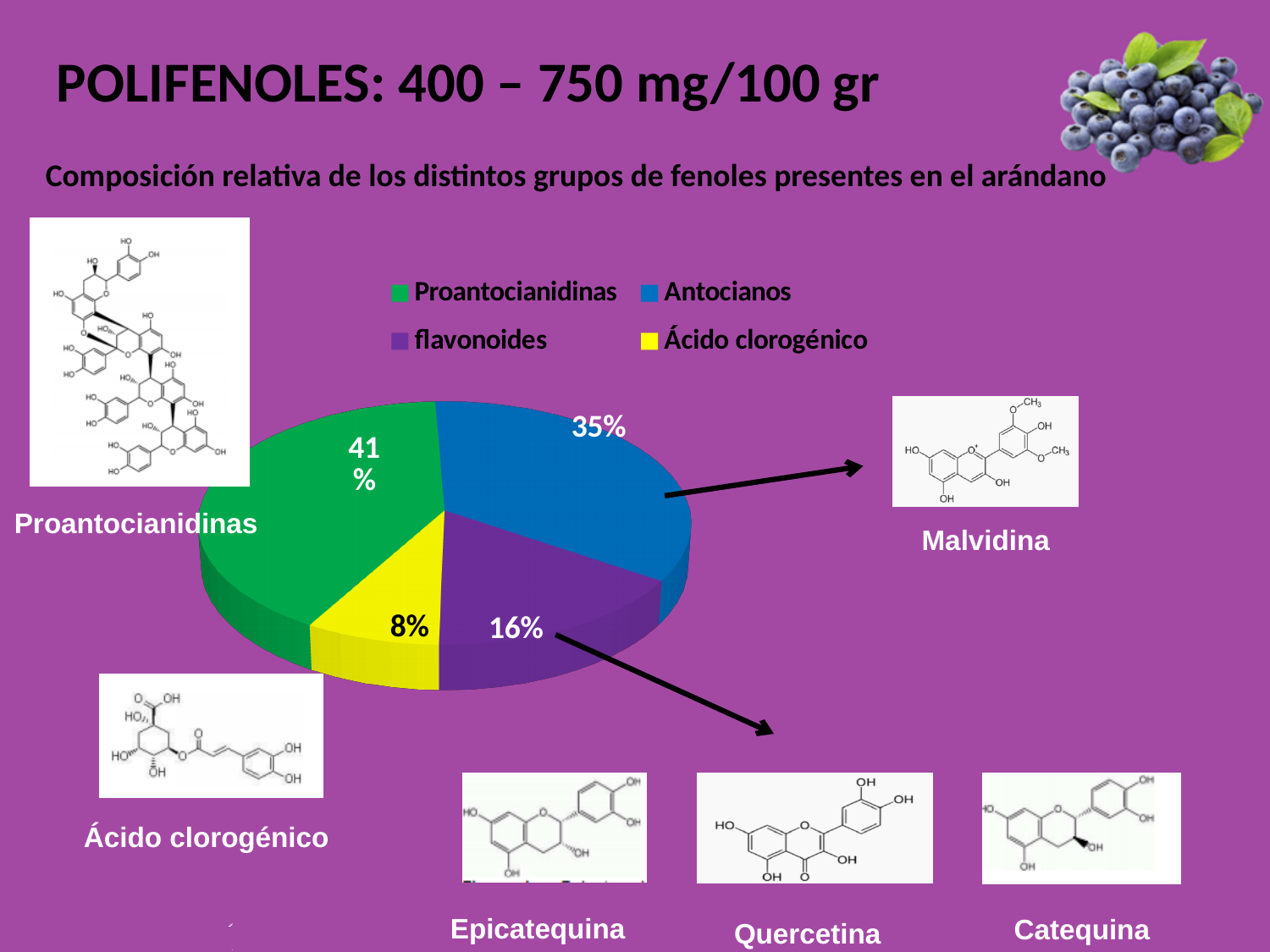
What is the difference in percentage points between flavonoides and Ácido clorogénico? 8 What percentage of the pie chart corresponds to Antocianos? 35% How many slices does the pie chart have? 4 What percentage of the pie chart corresponds to flavonoides? 16% What percentage of the pie chart corresponds to Ácido clorogénico? 8% Which group has the largest share of the pie chart? Proantocianidinas Which has a larger share, Antocianos or flavonoides? Antocianos Which group has the smallest share of the pie chart? Ácido clorogénico What percentage of the pie chart corresponds to Proantocianidinas? 41% What kind of chart is shown on the slide? pie chart What is the difference in percentage points between Proantocianidinas and Antocianos? 6 What colour is the slice for Ácido clorogénico? yellow